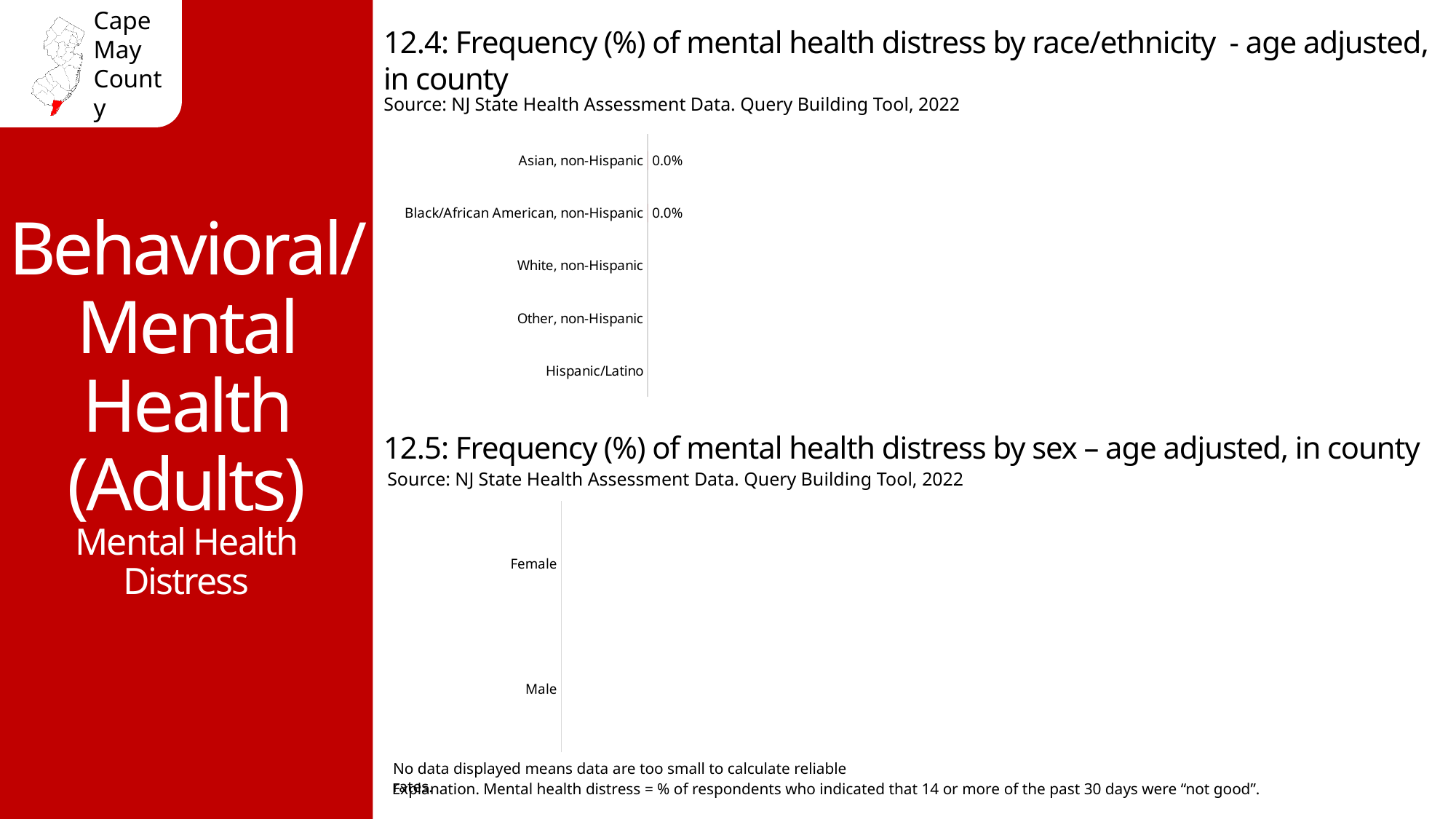
In the chart '12.5: Frequency (%) of mental health distress by sex – age adjusted, in county', how many categories are listed? 2 In the chart '12.4: Frequency (%) of mental health distress by race/ethnicity - age adjusted, in county', how many race/ethnicity categories are listed? 5 What is the source cited for the chart '12.4: Frequency (%) of mental health distress by race/ethnicity - age adjusted, in county'? NJ State Health Assessment Data. Query Building Tool, 2022 In the chart '12.4: Frequency (%) of mental health distress by race/ethnicity - age adjusted, in county', what value is shown for Black/African American, non-Hispanic? 0.0% In the chart '12.4: Frequency (%) of mental health distress by race/ethnicity - age adjusted, in county', how many categories have a printed value of 0.0%? 2 In the chart '12.4: Frequency (%) of mental health distress by race/ethnicity - age adjusted, in county', what value is shown for Asian, non-Hispanic? 0.0% In the chart '12.5: Frequency (%) of mental health distress by sex – age adjusted, in county', which two categories are listed? Female and Male In the chart '12.4: Frequency (%) of mental health distress by race/ethnicity - age adjusted, in county', which category is listed last (at the bottom)? Hispanic/Latino